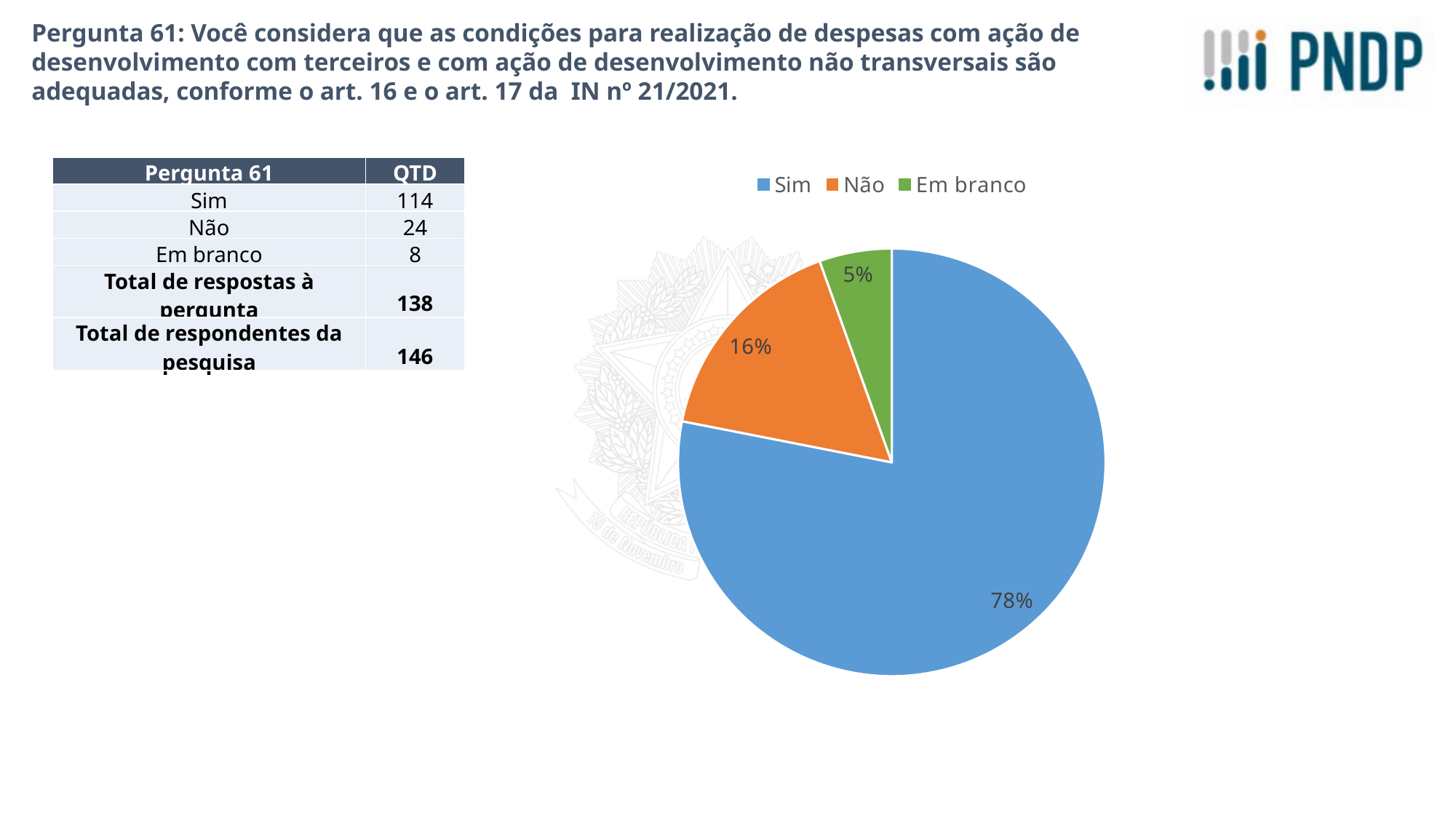
How many entries does the legend of the pie chart list? 3 How many slices does the pie chart have? 3 Which category has the largest slice in the pie chart? Sim What percentage of the pie chart does the "Sim" slice represent? 78% Which category has the smallest slice in the pie chart? Em branco What colour is the "Em branco" slice in the pie chart? green What colour is the "Sim" slice in the pie chart? blue What percentage of the pie chart does the "Não" slice represent? 16% What type of chart is shown on the slide? pie chart Which slice is larger in the pie chart, "Não" or "Em branco"? Não What percentage of the pie chart does the "Em branco" slice represent? 5% What is the difference in percentage points between the "Sim" slice and the "Não" slice? 62